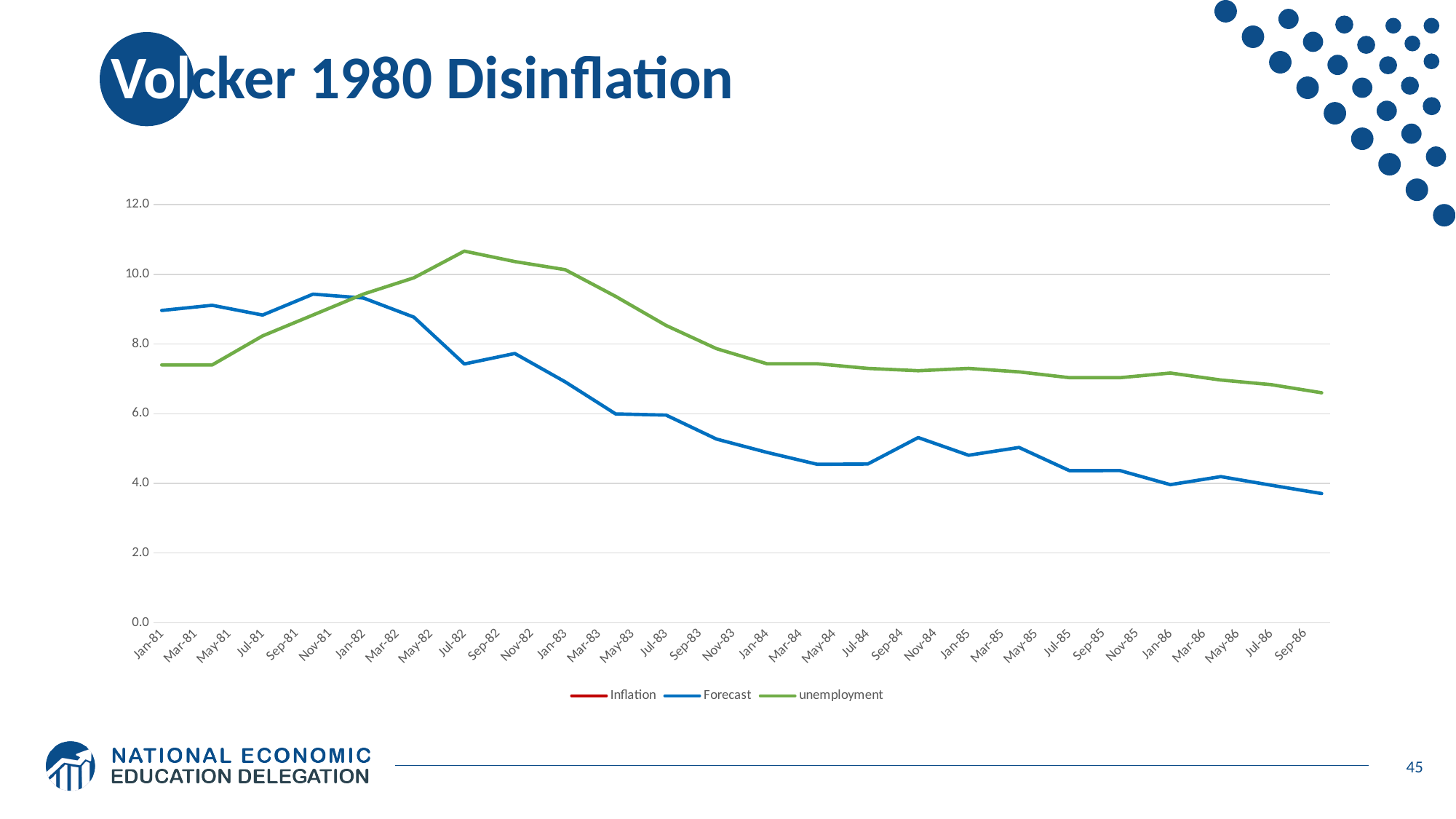
How many series does the legend list? 3 Does the Forecast line generally rise or fall from Jan-81 to Sep-86? fall What colour is the unemployment line? green What kind of chart is shown on the slide? line chart What is the title of the chart's slide? Volcker 1980 Disinflation At which month does the unemployment line reach its highest value? Jul-82 Is the unemployment value for Jul-82 greater or less than 10.0? greater Is the Forecast value for Nov-84 greater or less than 4.0? greater At which month does the Forecast line reach its lowest value? Sep-86 At Sep-86, which is larger: the Forecast value or the unemployment value? unemployment Is the unemployment value for Sep-86 greater or less than 8.0? less